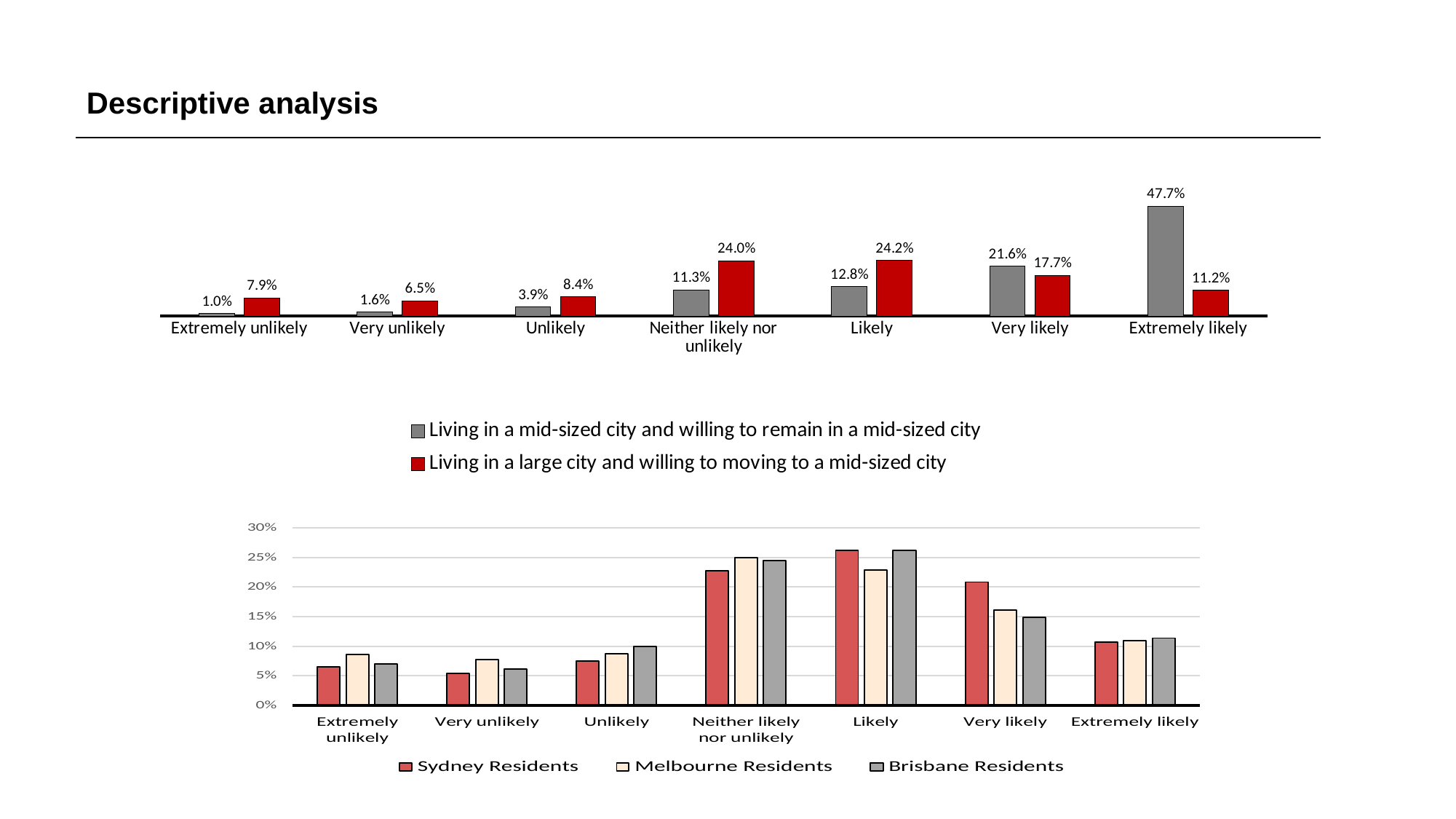
In the top chart, which category has the highest value for the 'Living in a large city and willing to moving to a mid-sized city' series? Likely In the top chart, what is the value for 'Neither likely nor unlikely' in the 'Living in a large city and willing to moving to a mid-sized city' series? 24.0% How many series does the legend of the bottom chart list? 3 In the top chart, for 'Very likely', which series has the larger value? Living in a mid-sized city and willing to remain in a mid-sized city In the bottom chart, is the value for Sydney Residents in the 'Likely' category greater or less than 25%? greater How many categories are shown on the x axis of the top chart? 7 What kind of chart is the bottom chart? bar chart In the bottom chart, is the value for Sydney Residents in the 'Very unlikely' category greater or less than 10%? less In the top chart, which category has the lowest value for the 'Living in a mid-sized city and willing to remain in a mid-sized city' series? Extremely unlikely In the top chart, what is the value for 'Extremely likely' in the 'Living in a mid-sized city and willing to remain in a mid-sized city' series? 47.7% In the bottom chart, which series is shown in red? Sydney Residents In the top chart, what is the difference between the two series' values for 'Extremely likely'? 36.5%